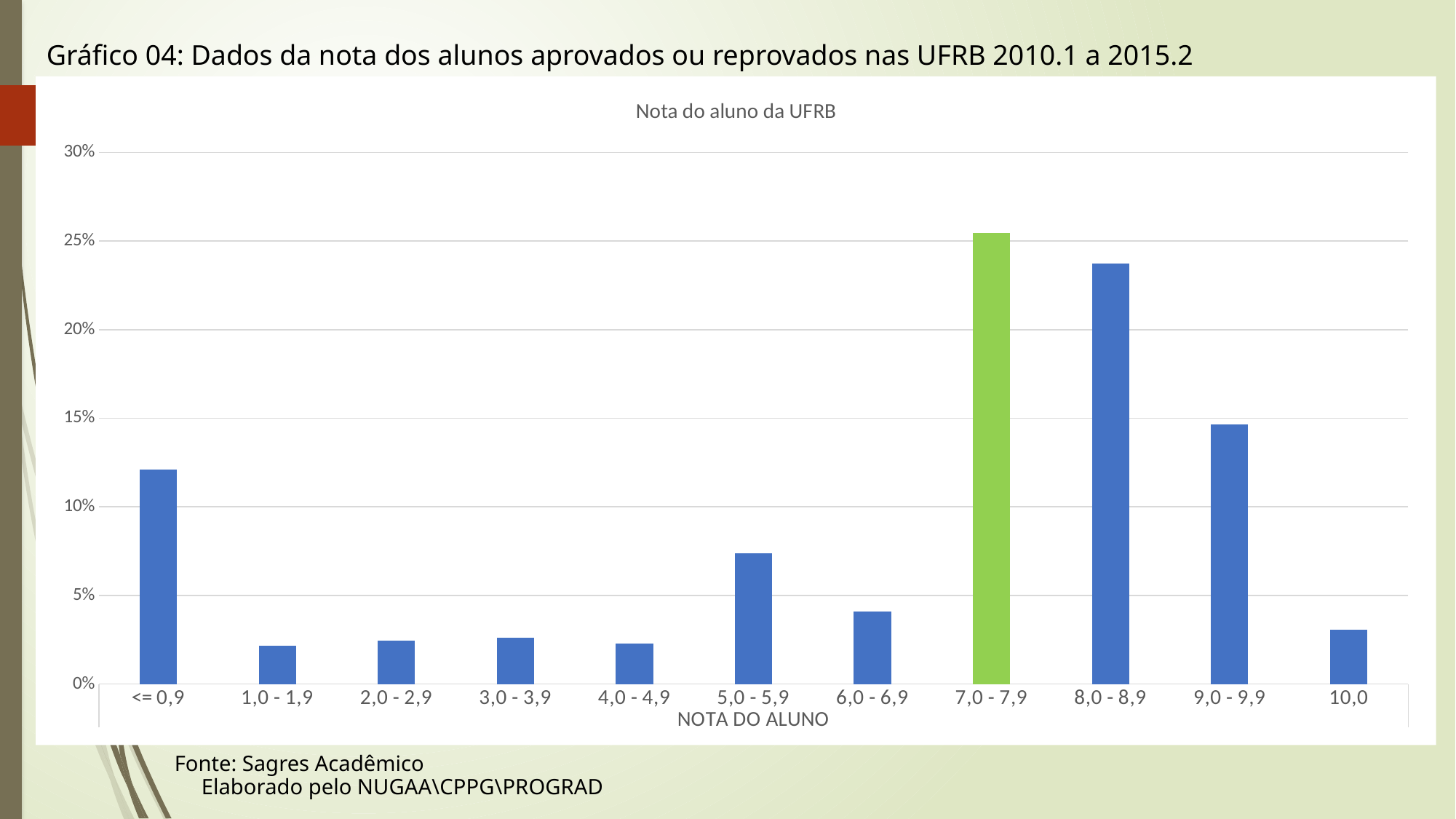
Which grade category is shown with a green bar instead of blue? 7,0 - 7,9 Is the value for 8,0 - 8,9 greater or less than 25%? less Is the value for 7,0 - 7,9 greater or less than 25%? greater Is the value for 9,0 - 9,9 greater or less than 15%? less What kind of chart is shown on the slide? bar chart Which is larger, the value for <= 0,9 or the value for 5,0 - 5,9? <= 0,9 How many grade categories are shown on the x axis? 11 Which is larger, the value for 8,0 - 8,9 or the value for 9,0 - 9,9? 8,0 - 8,9 Which grade category has the highest percentage? 7,0 - 7,9